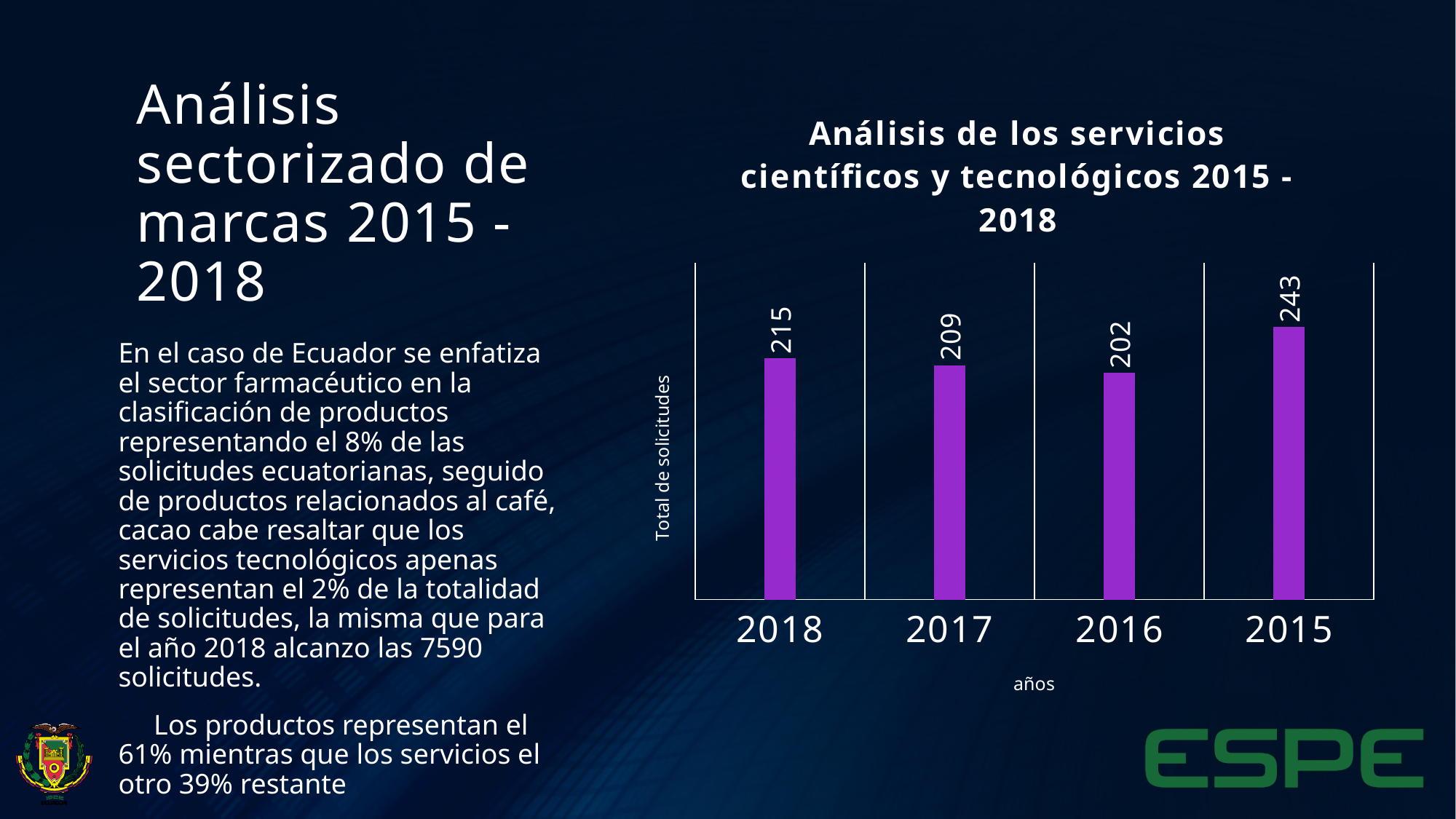
Which year has the lowest total de solicitudes? 2016 What is the difference between the values for 2015 and 2016? 41 How many years are shown on the x axis of the chart? 4 Which year has the highest total de solicitudes? 2015 What is the value for 2016 in the chart? 202 What is the label of the vertical axis of the chart? Total de solicitudes Which is larger, the value for 2017 or the value for 2015? 2015 What is the difference between the values for 2018 and 2017? 6 What is the value for 2018 in the chart? 215 What is the value for 2015 in the chart? 243 What is the title of the chart? Análisis de los servicios científicos y tecnológicos 2015 - 2018 What kind of chart is shown on the slide? bar chart